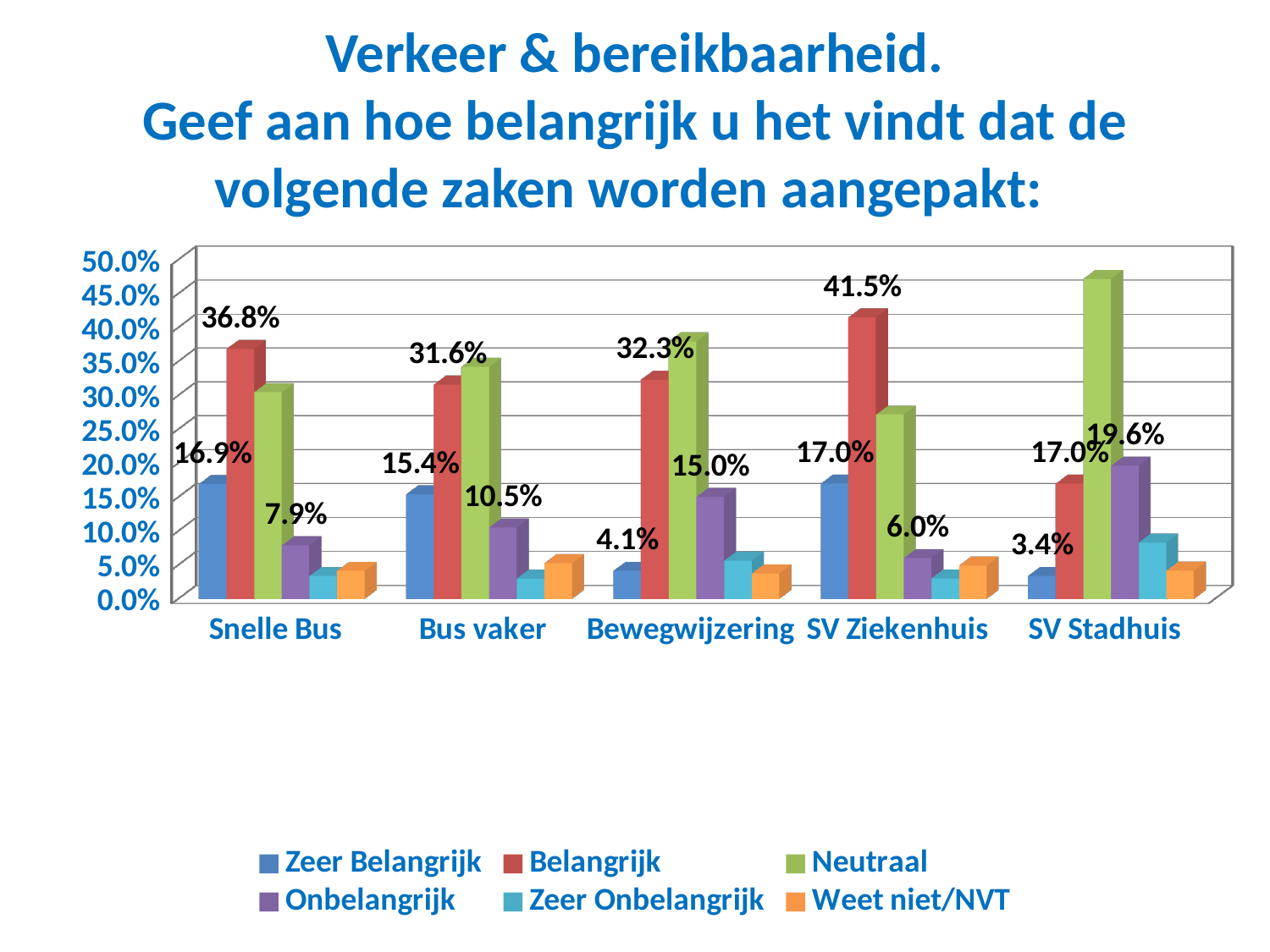
What is the value for Belangrijk for SV Ziekenhuis? 41.5% What is the difference between the Belangrijk values for Snelle Bus and Bus vaker? 5.2 percentage points What is the value for Onbelangrijk for SV Stadhuis? 19.6% Which category has the lowest value for Zeer Belangrijk? SV Stadhuis What is the value for Zeer Belangrijk for Snelle Bus? 16.9% Is the Neutraal value for SV Stadhuis greater or less than 40%? greater Which is larger: the Onbelangrijk value for Bewegwijzering or for Bus vaker? Bewegwijzering What is the value for Zeer Belangrijk for Bewegwijzering? 4.1% How many categories are shown on the x axis? 5 Which category has the highest value for Belangrijk? SV Ziekenhuis What kind of chart is shown on the slide? bar chart How many series does the legend list? 6